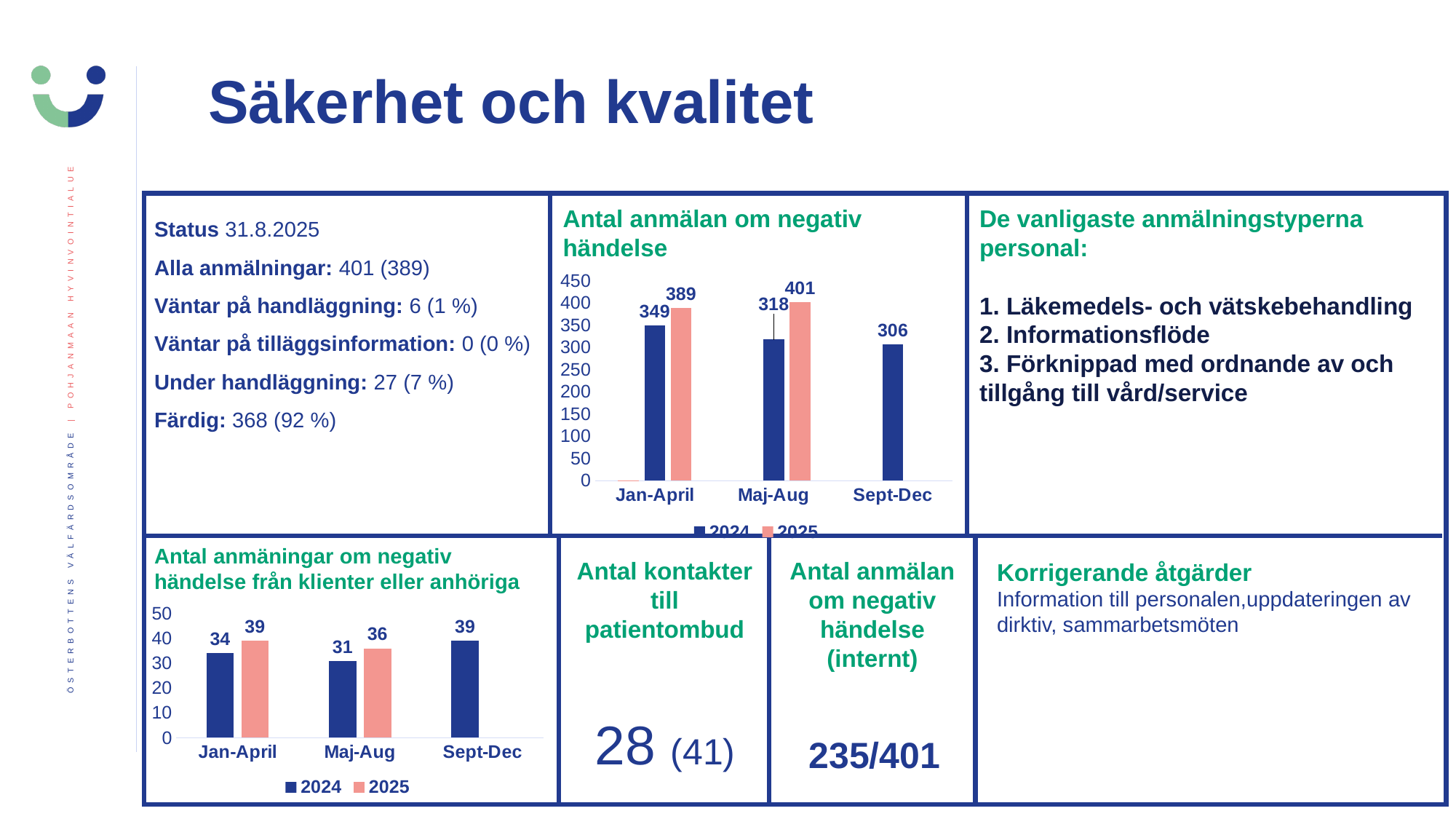
In the chart 'Antal anmälan om negativ händelse', how many series does the legend list? 2 In the chart 'Antal anmälan om negativ händelse', what is the value for 2025 in Maj-Aug? 401 In the chart 'Antal anmäningar om negativ händelse från klienter eller anhöriga', which period has the highest 2024 value? Sept-Dec In the chart 'Antal anmälan om negativ händelse', what is the value for 2024 in Jan-April? 349 In the chart 'Antal anmälan om negativ händelse', do the 2024 values rise or fall from Jan-April to Sept-Dec? fall In the chart 'Antal anmälan om negativ händelse', is the 2024 value for Maj-Aug greater or less than 350? less In the chart 'Antal anmälan om negativ händelse', what is the difference between the 2025 and 2024 values in Jan-April? 40 In the chart 'Antal anmäningar om negativ händelse från klienter eller anhöriga', what is the value for 2025 in Maj-Aug? 36 In the chart 'Antal anmäningar om negativ händelse från klienter eller anhöriga', how many periods are shown on the x axis? 3 What type of chart is 'Antal anmäningar om negativ händelse från klienter eller anhöriga'? bar chart In the chart 'Antal anmälan om negativ händelse', which period has the lowest 2024 value? Sept-Dec In the chart 'Antal anmäningar om negativ händelse från klienter eller anhöriga', which is larger in Jan-April, the 2024 value or the 2025 value? 2025